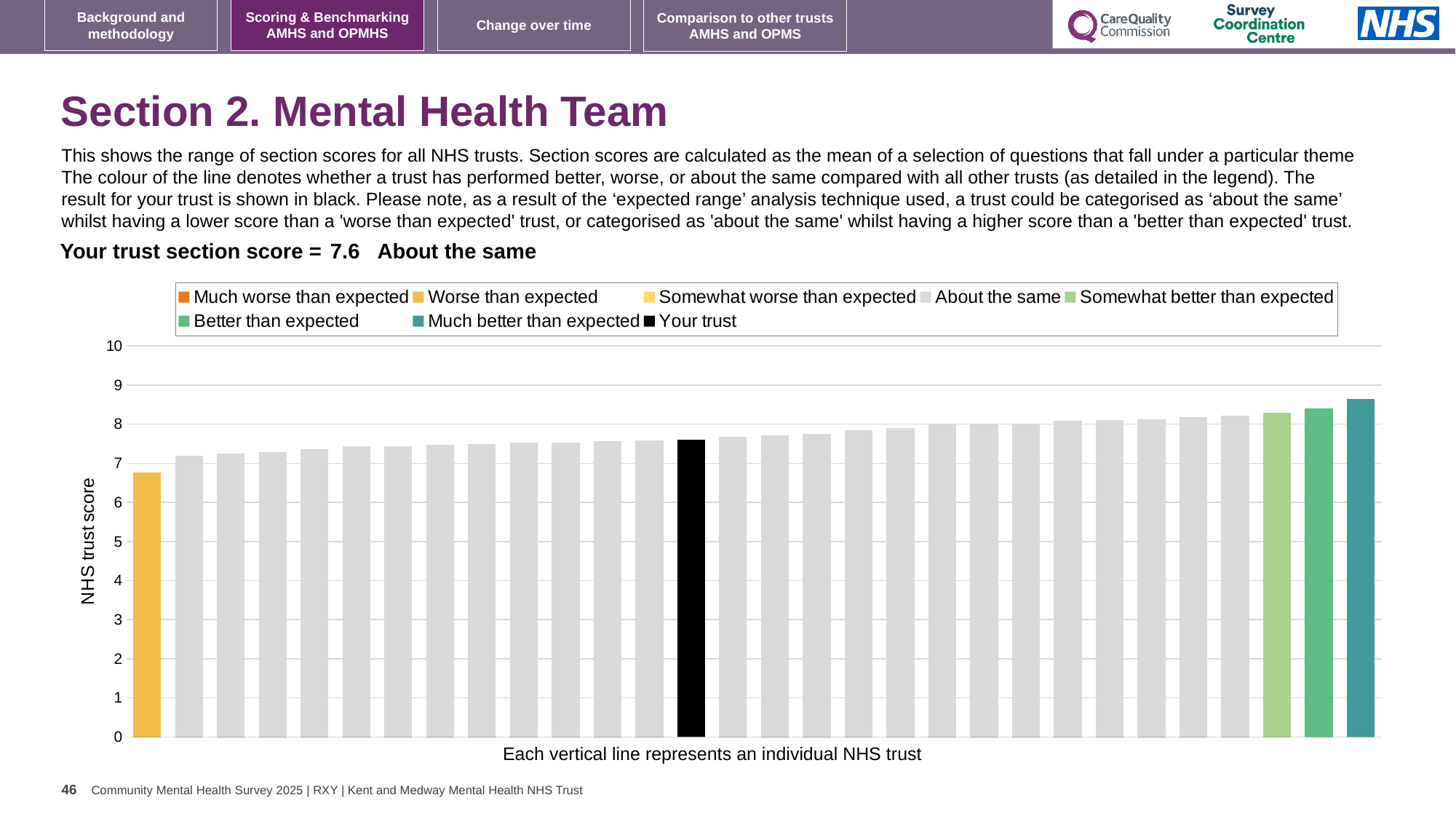
Which legend category does the lowest bar belong to? Worse than expected Is the value of the yellow 'Worse than expected' bar greater or less than 7? less How many bars are coloured as 'Worse than expected'? 1 Is the value of the black 'Your trust' bar greater or less than 8? less What is the section score for your trust (the black bar)? 7.6 What is the label on the vertical axis of the chart? NHS trust score How many bars (NHS trusts) are plotted in the chart? 30 Which legend category does the highest bar belong to? Much better than expected Do the bar values rise or fall from left to right across the chart? Rise What kind of chart is shown on the slide? Bar chart Is the value of the tallest bar greater or less than 8? greater How many entries does the chart legend list? 8